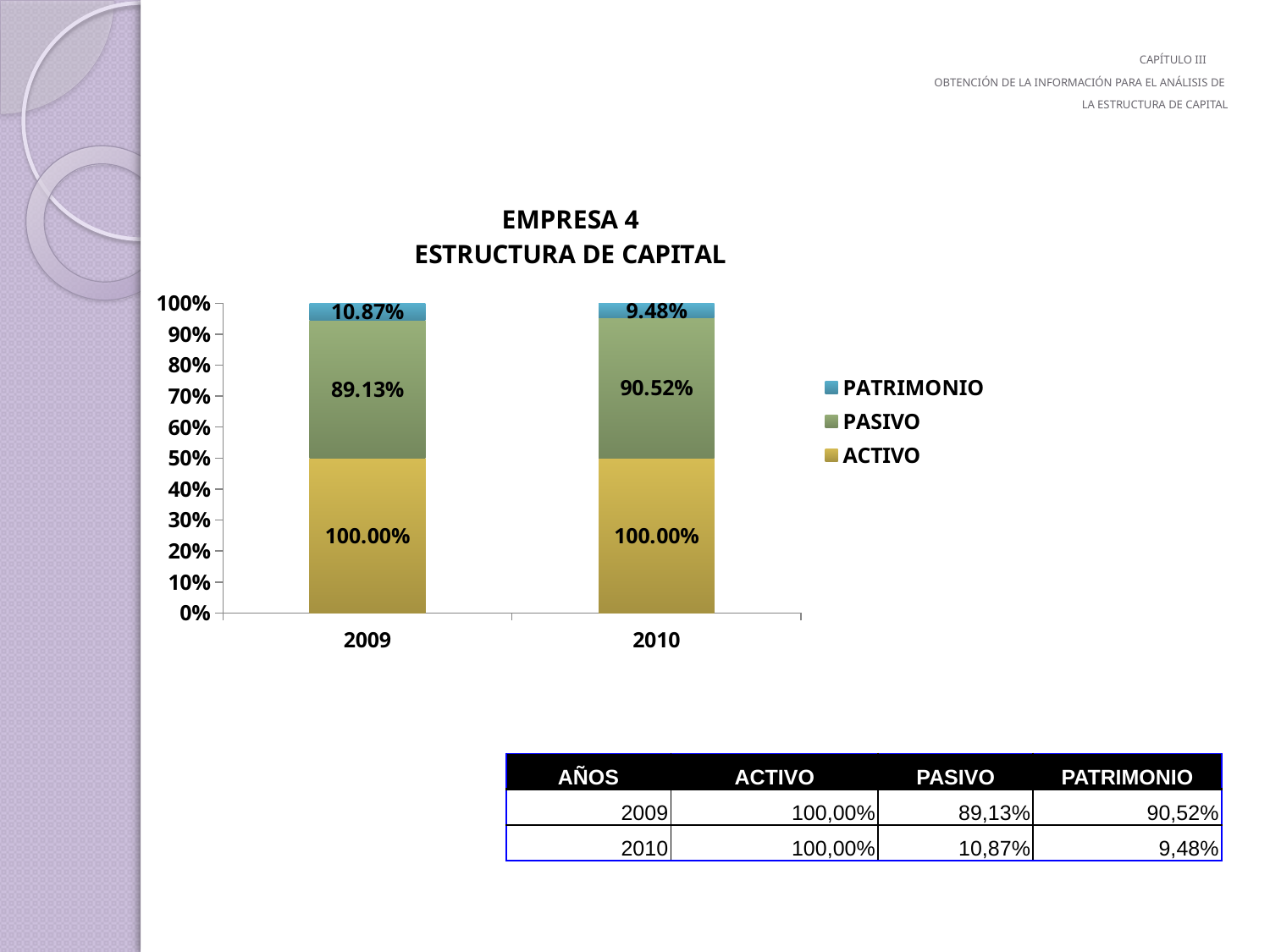
What is the data label for PATRIMONIO in 2009? 10.87% What is the data label for ACTIVO in 2010? 100.00% What is the data label for PATRIMONIO in 2010? 9.48% How many years are shown on the x axis of the chart? 2 Does the PATRIMONIO label rise or fall from 2009 to 2010? Fall Which year has the larger PASIVO label, 2009 or 2010? 2010 What is the data label for PASIVO in 2009? 89.13% What is the data label for PASIVO in 2010? 90.52% What type of chart is shown on the slide? Stacked bar chart By how many percentage points does the PASIVO label for 2010 exceed the PASIVO label for 2009? 1.39 How many series does the chart legend list? 3 Which year has the larger PATRIMONIO label, 2009 or 2010? 2009